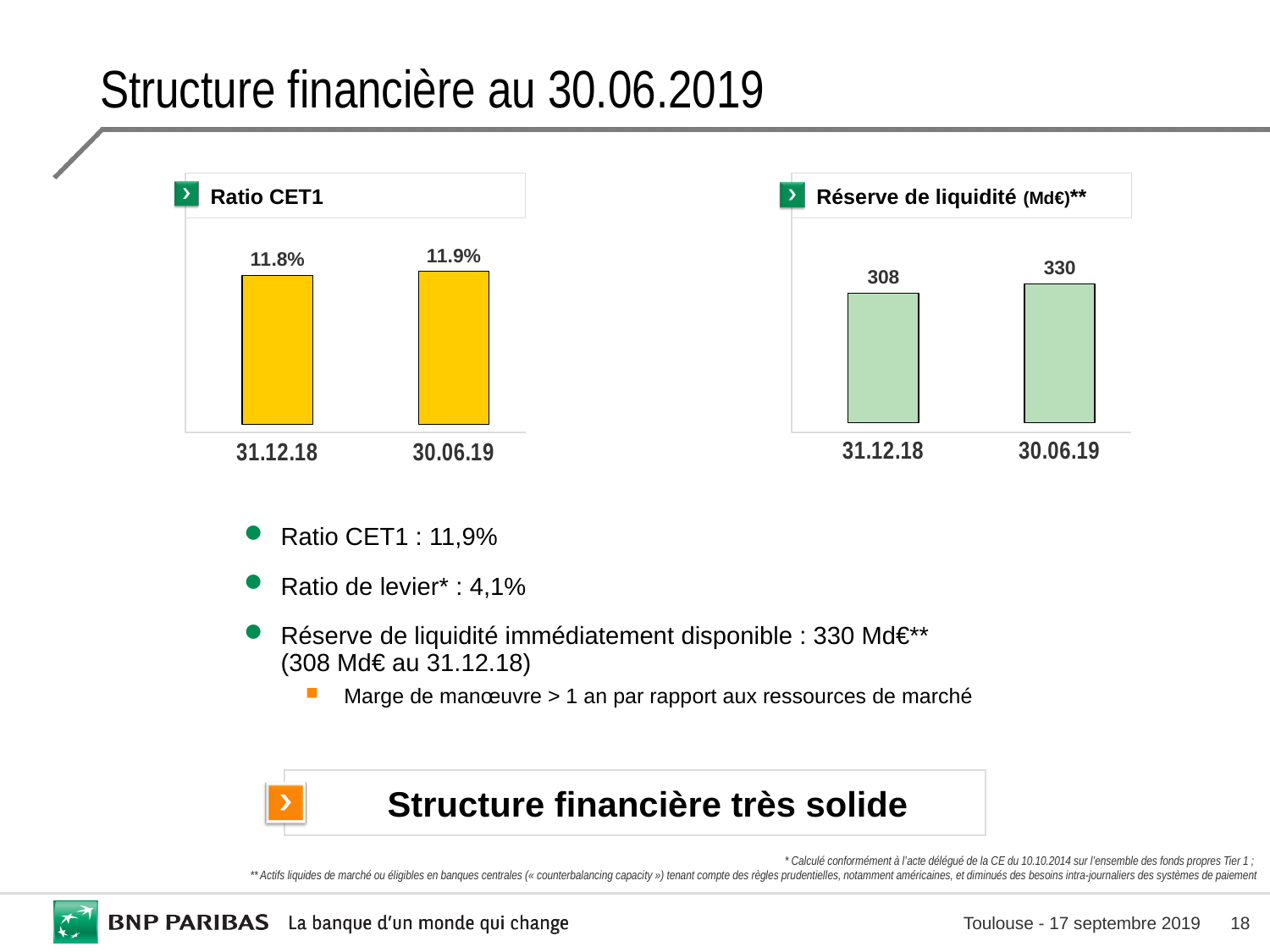
In the Réserve de liquidité chart, is the value for 31.12.18 larger or smaller than the value for 30.06.19? smaller In the Réserve de liquidité chart, what is the value for 31.12.18? 308 What unit is indicated in the title of the Réserve de liquidité chart? Md€ In the Ratio CET1 chart, what is the difference between the 30.06.19 and 31.12.18 values? 0.1% How many bars are shown in the Ratio CET1 chart? 2 In the Ratio CET1 chart, what is the value for 31.12.18? 11.8% In the Réserve de liquidité chart, what is the value for 30.06.19? 330 In the Ratio CET1 chart, what is the value for 30.06.19? 11.9% In the Réserve de liquidité chart, what is the difference between the 30.06.19 and 31.12.18 values? 22 What type of chart is the Réserve de liquidité chart? bar chart In the Réserve de liquidité chart, do the values rise or fall from 31.12.18 to 30.06.19? rise In the Réserve de liquidité chart, which date has the higher value? 30.06.19